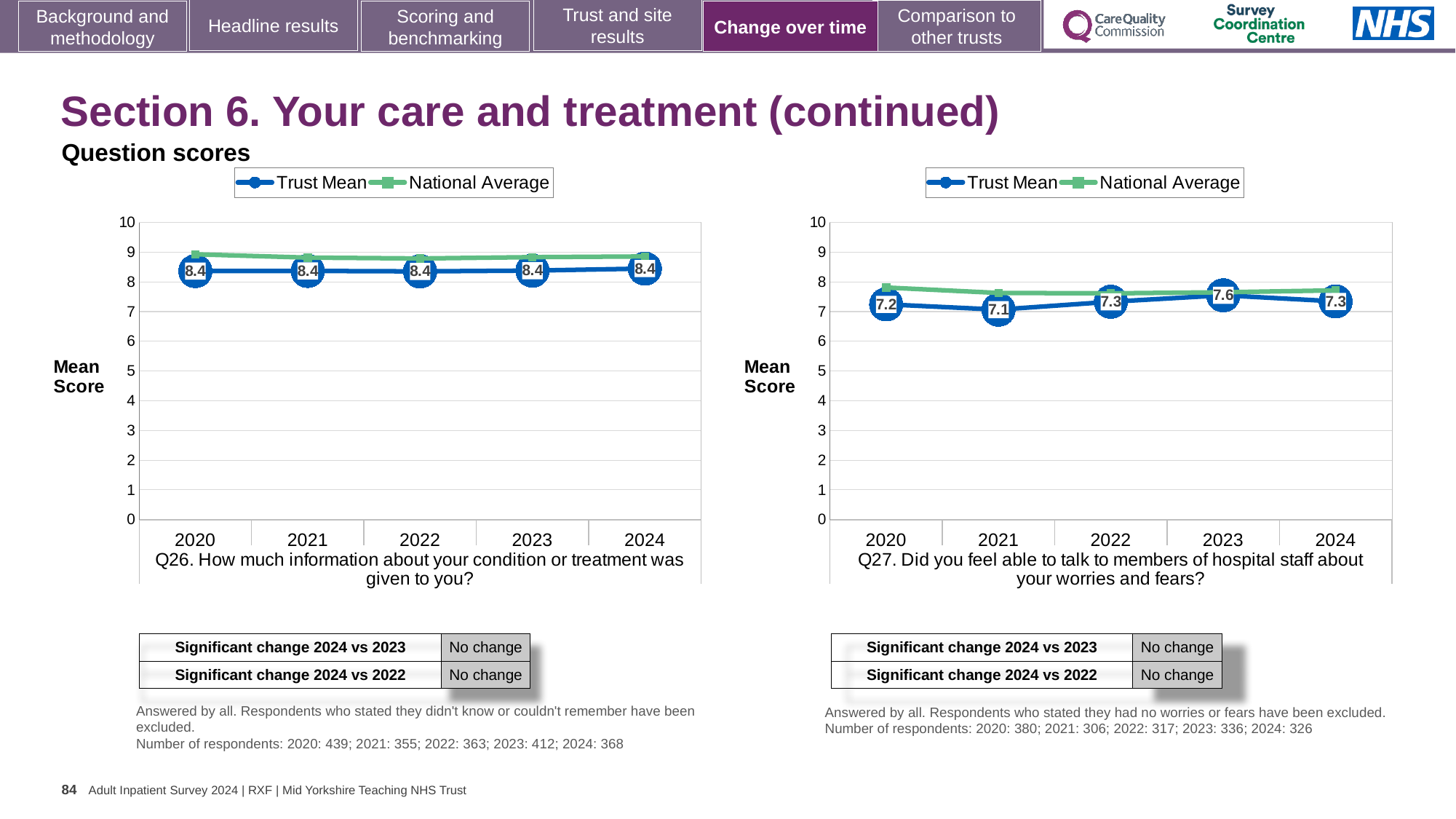
How many years are shown on the x axis of the Q26 chart (left)? 5 In the Q27 chart (right), what is the Trust Mean score for 2021? 7.1 In the Q27 chart (right), which year has the lowest Trust Mean score? 2021 In the Q27 chart (right), is the National Average value for 2021 greater or less than 8? less In the Q27 chart (right), is the Trust Mean score for 2022 larger or smaller than the Trust Mean score for 2023? smaller In the Q26 chart (left), does the Trust Mean score rise, fall or stay the same from 2020 to 2024? stays the same What kind of chart is the Q26 chart (left)? line chart In the Q26 chart (left), what is the Trust Mean score for 2024? 8.4 In the Q27 chart (right), which year has the highest Trust Mean score? 2023 In the Q27 chart (right), what is the difference between the Trust Mean scores for 2023 and 2021? 0.5 In the Q26 chart (left), is the National Average value for 2020 greater or less than 8? greater How many series does the legend of the Q27 chart (right) list? 2